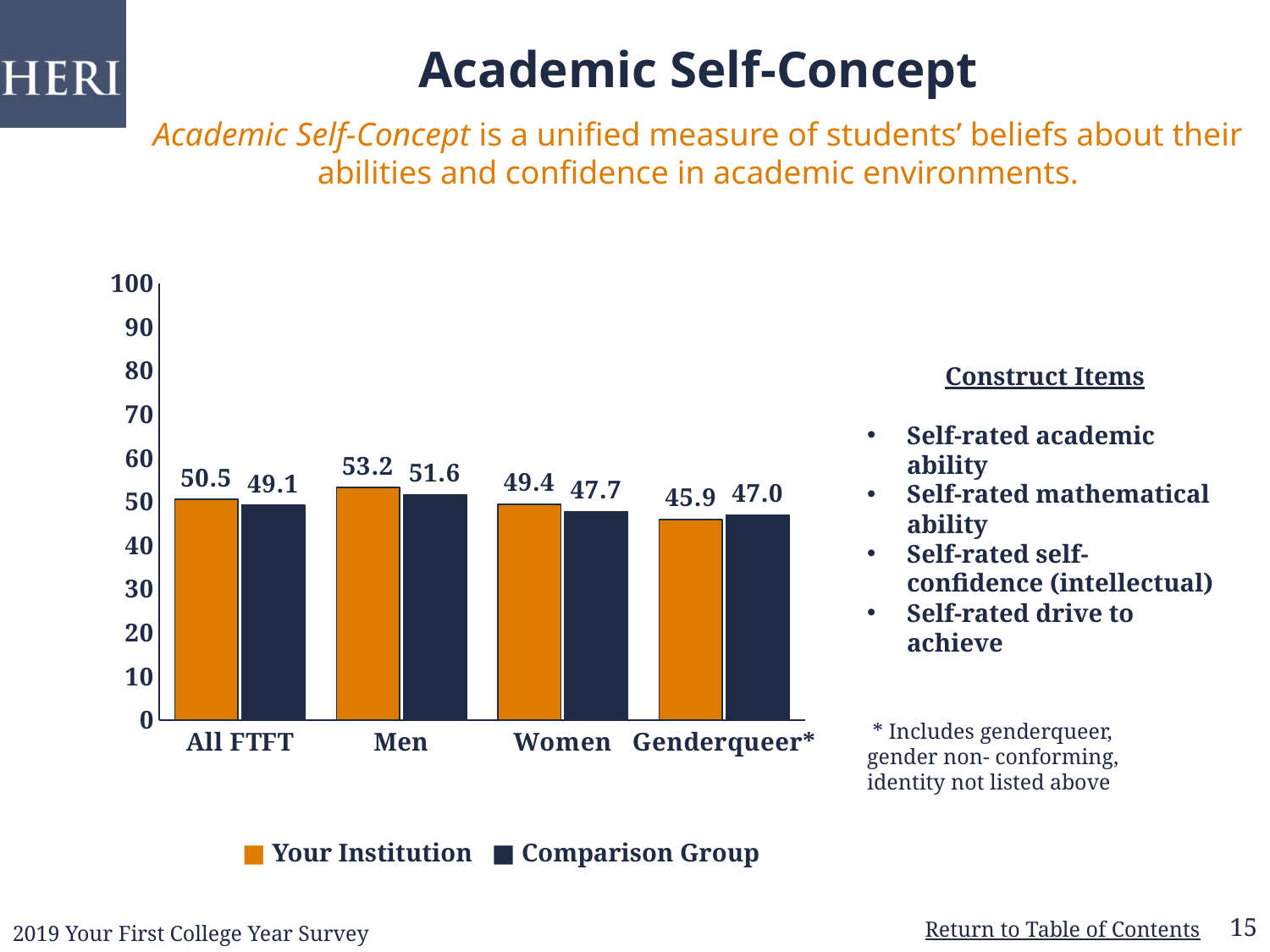
What is the Your Institution value for All FTFT? 50.5 What kind of chart is shown on the slide? Bar chart What is the difference between the Your Institution and Comparison Group values for Women? 1.7 What is the Comparison Group value for Genderqueer*? 47.0 For Genderqueer*, which is larger: the Your Institution value or the Comparison Group value? Comparison Group Which category has the lowest Comparison Group value? Genderqueer* Which colour represents Your Institution in the legend? Orange How many series does the legend list? 2 How many categories are shown on the x axis? 4 What is the difference between the Your Institution values for Men and Genderqueer*? 7.3 Which category has the highest Your Institution value? Men What is the Your Institution value for Men? 53.2